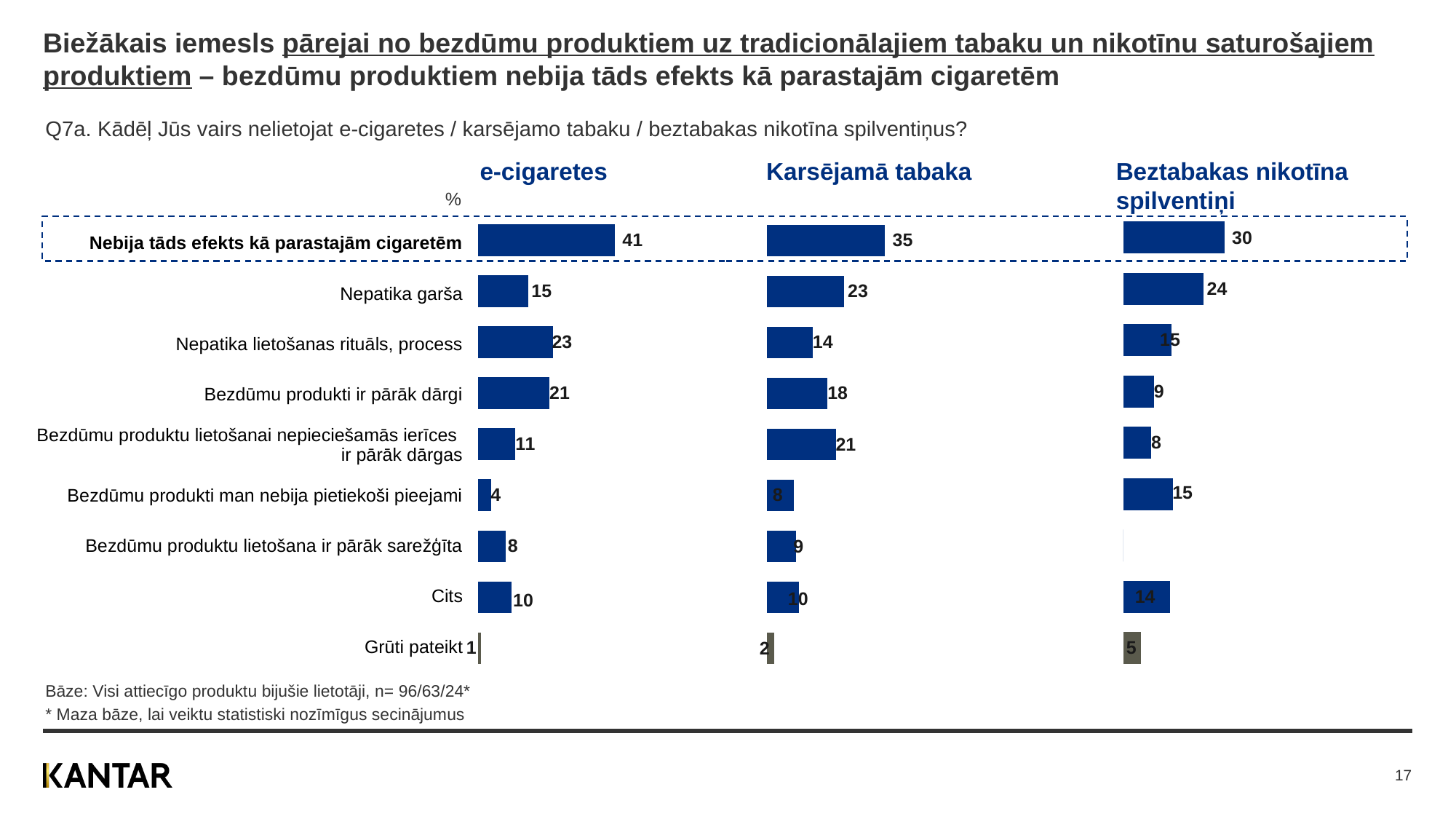
How many categories are listed on the left of the charts? 9 In the Karsējamā tabaka chart, which category has the lowest value? Grūti pateikt In the e-cigaretes chart, which category has the highest value? Nebija tāds efekts kā parastajām cigaretēm For "Bezdūmu produkti ir pārāk dārgi", which chart shows the larger value: e-cigaretes or Beztabakas nikotīna spilventiņi? e-cigaretes What is the difference between the e-cigaretes value and the Karsējamā tabaka value for "Nebija tāds efekts kā parastajām cigaretēm"? 6 What type of chart is used on this slide? Bar chart What is the value for "Cits" in the Beztabakas nikotīna spilventiņi chart? 14 In the Karsējamā tabaka chart, what is the value for "Nepatika garša"? 23 In the Karsējamā tabaka chart, what is the difference between "Bezdūmu produktu lietošanai nepieciešamās ierīces ir pārāk dārgas" and "Bezdūmu produkti ir pārāk dārgi"? 3 In the Beztabakas nikotīna spilventiņi chart, what is the value for "Bezdūmu produkti man nebija pietiekoši pieejami"? 15 In the Beztabakas nikotīna spilventiņi chart, which category has the highest value? Nebija tāds efekts kā parastajām cigaretēm In the e-cigaretes chart, what is the value for "Nebija tāds efekts kā parastajām cigaretēm"? 41